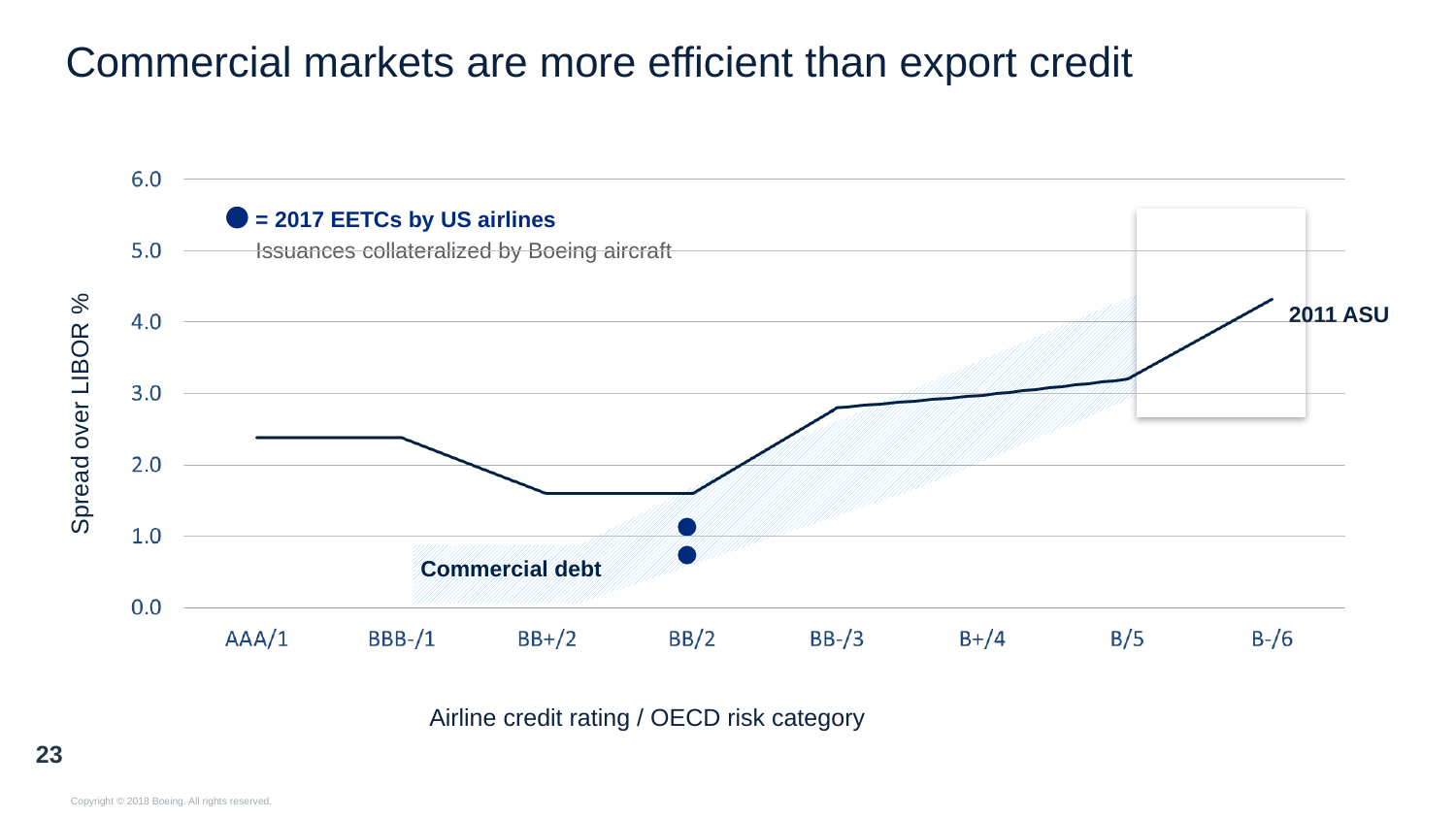
Is the 2011 ASU value for AAA/1 greater or less than 2.0? greater Is the 2011 ASU value for B-/6 greater or less than 4.0? greater Is the 2011 ASU value for BB-/3 greater or less than 3.0? less Which credit rating category has the highest 2011 ASU spread over LIBOR? B-/6 According to the legend, what do the blue dots represent? 2017 EETCs by US airlines Which has a larger 2011 ASU spread, B-/6 or AAA/1? B-/6 What is the label of the y axis? Spread over LIBOR % Does the 2011 ASU line rise or fall from BB/2 to B-/6? rise What kind of chart is shown on the slide? line chart How many credit rating categories are shown on the x axis? 8 Which has a larger 2011 ASU spread, BB-/3 or BB/2? BB-/3